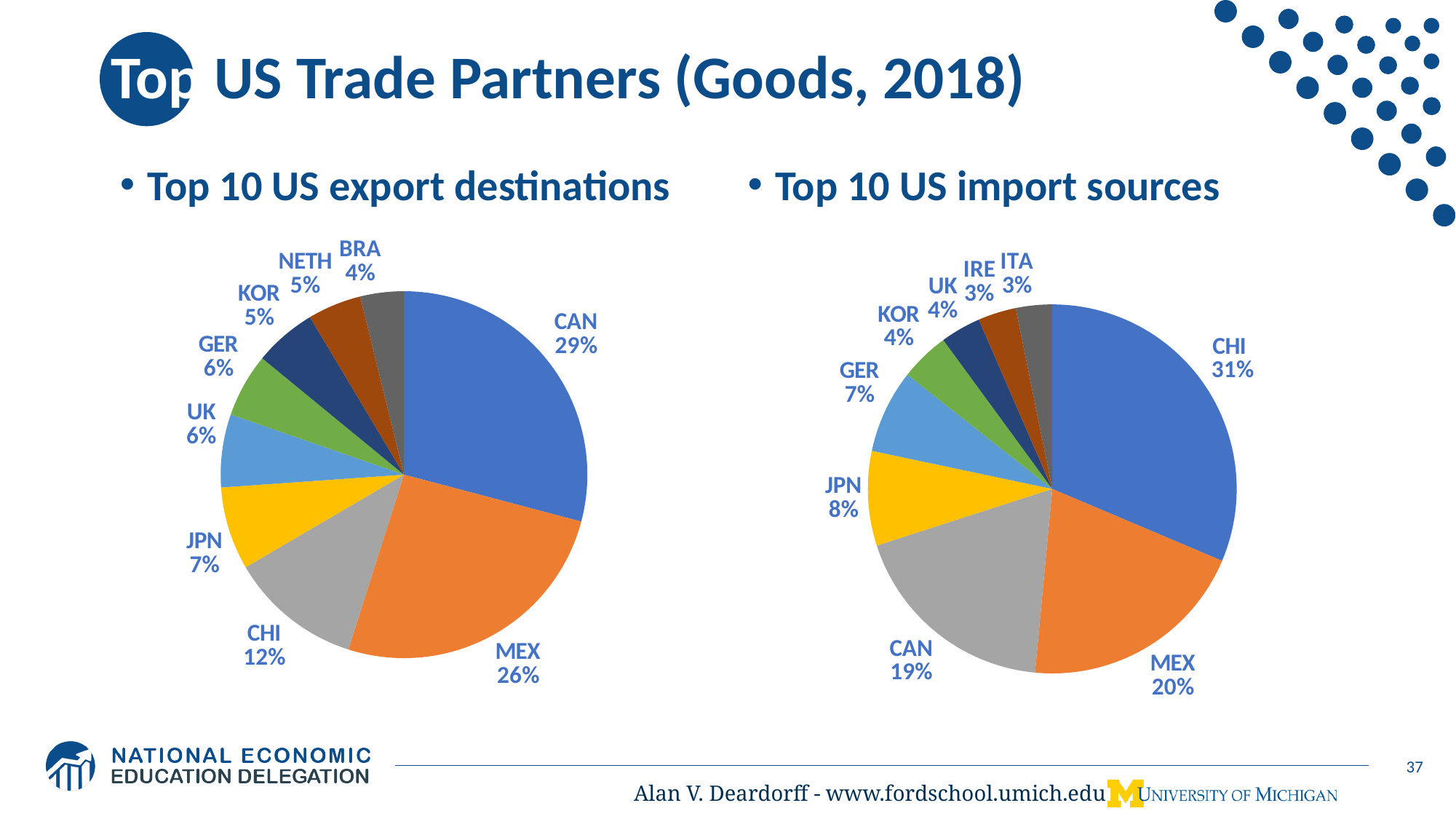
In the Top 10 US import sources chart, which source has the largest share? CHI In the Top 10 US export destinations chart, which destination has the largest share? CAN How many slices does the Top 10 US import sources chart have? 9 In the Top 10 US export destinations chart, which destination has the smallest share? BRA In the Top 10 US export destinations chart, which is larger, the share for CHI or the share for JPN? CHI In the Top 10 US export destinations chart, what share of exports goes to CAN? 29% In the Top 10 US import sources chart, what is the difference between the shares for CHI and CAN? 12% What kind of chart is used for the Top 10 US export destinations? Pie chart In the Top 10 US import sources chart, what share of imports comes from CHI? 31% In the Top 10 US import sources chart, which is larger, the share for JPN or the share for GER? JPN In the Top 10 US export destinations chart, what is the difference between the shares for CAN and MEX? 3% In the Top 10 US import sources chart, what share of imports comes from MEX? 20%